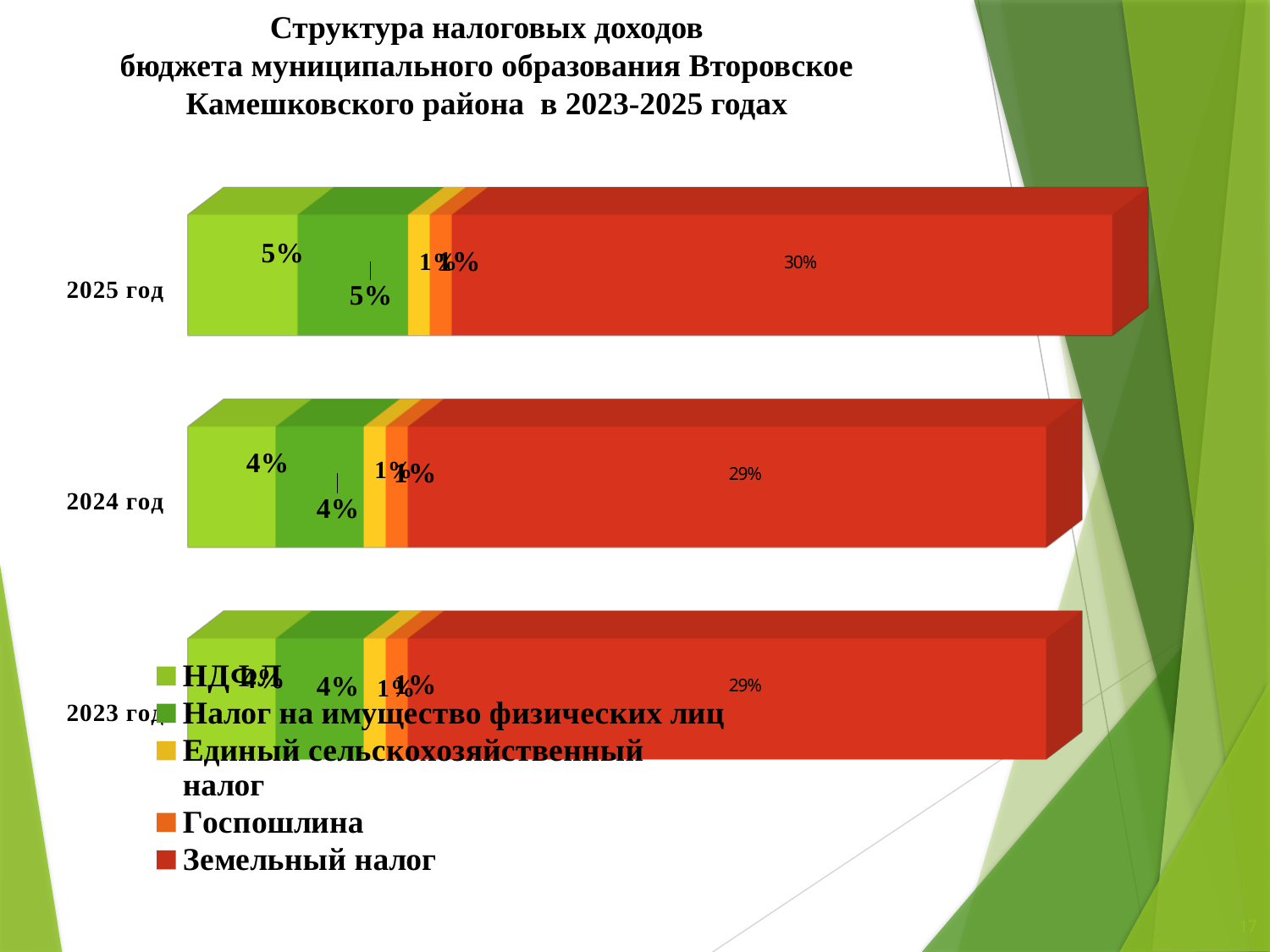
What kind of chart is shown on the slide? bar chart By how many percentage points does Земельный налог in 2025 год exceed Земельный налог in 2024 год? 1 Which year has the larger value for НДФЛ, 2024 год or 2025 год? 2025 год What colour represents Земельный налог in the legend? red Which series has the largest value in 2025 год? Земельный налог How many series does the legend list? 5 What is the value for НДФЛ in 2025 год? 5% What is the value for Налог на имущество физических лиц in 2024 год? 4% What is the value for Земельный налог in 2025 год? 30% What is the value for Земельный налог in 2024 год? 29% What is the value for Госпошлина in 2025 год? 1% How many years (categories) are plotted in the chart? 3